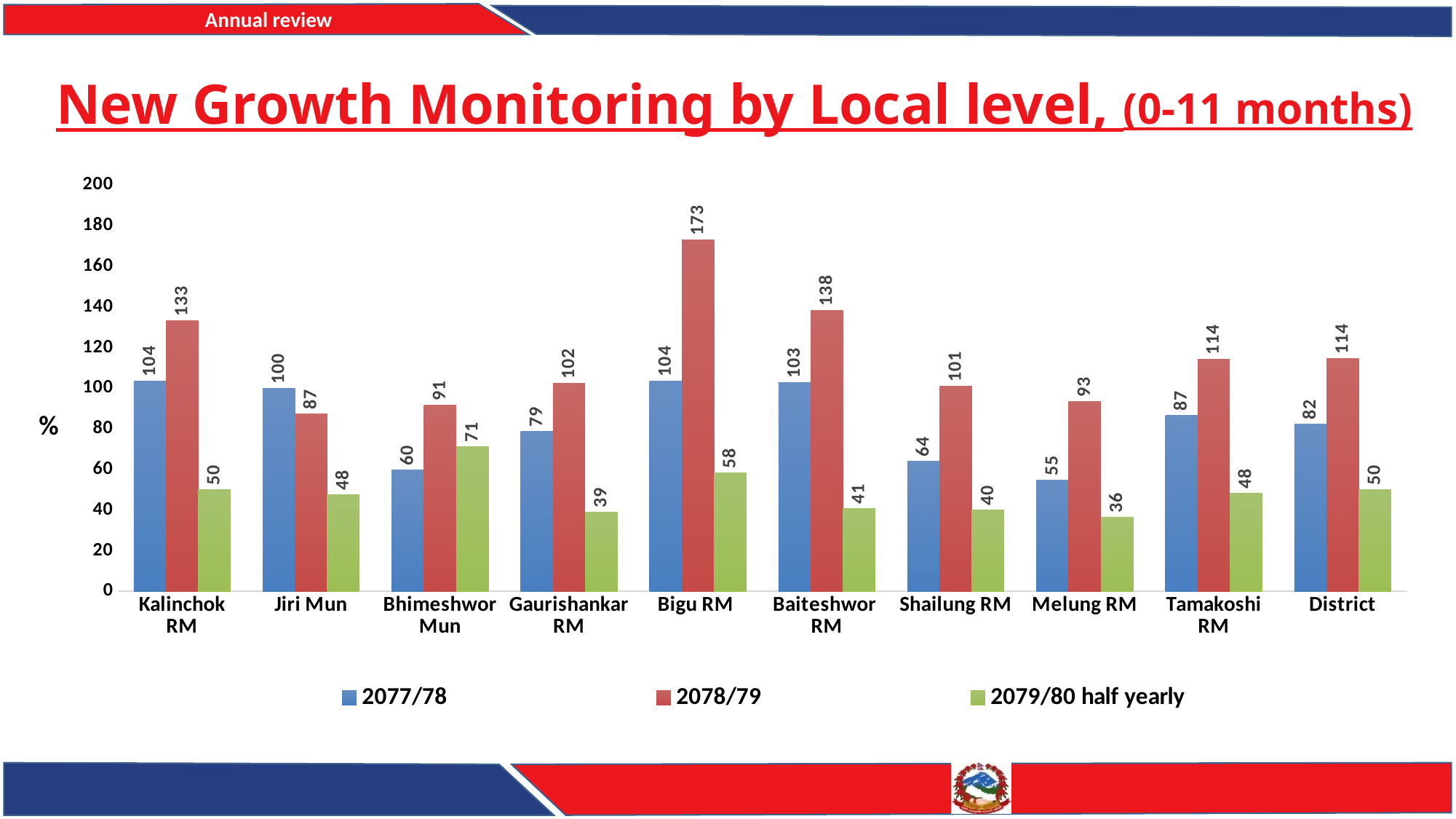
What is the 2078/79 value for Bigu RM? 173 Which local level has the lowest 2079/80 half yearly value? Melung RM Which is larger for Jiri Mun: the 2077/78 value or the 2078/79 value? 2077/78 How many local level categories are shown on the x axis? 10 Which local level has the highest 2078/79 value? Bigu RM What is the difference between the 2078/79 and 2077/78 values for Kalinchok RM? 29 What is the 2079/80 half yearly value for Bhimeshwor Mun? 71 What is the label on the vertical axis? % What is the 2077/78 value for Melung RM? 55 How many series does the legend list? 3 What kind of chart is shown on the slide? Bar chart Is the 2078/79 value for Baiteshwor RM greater or less than 120? greater